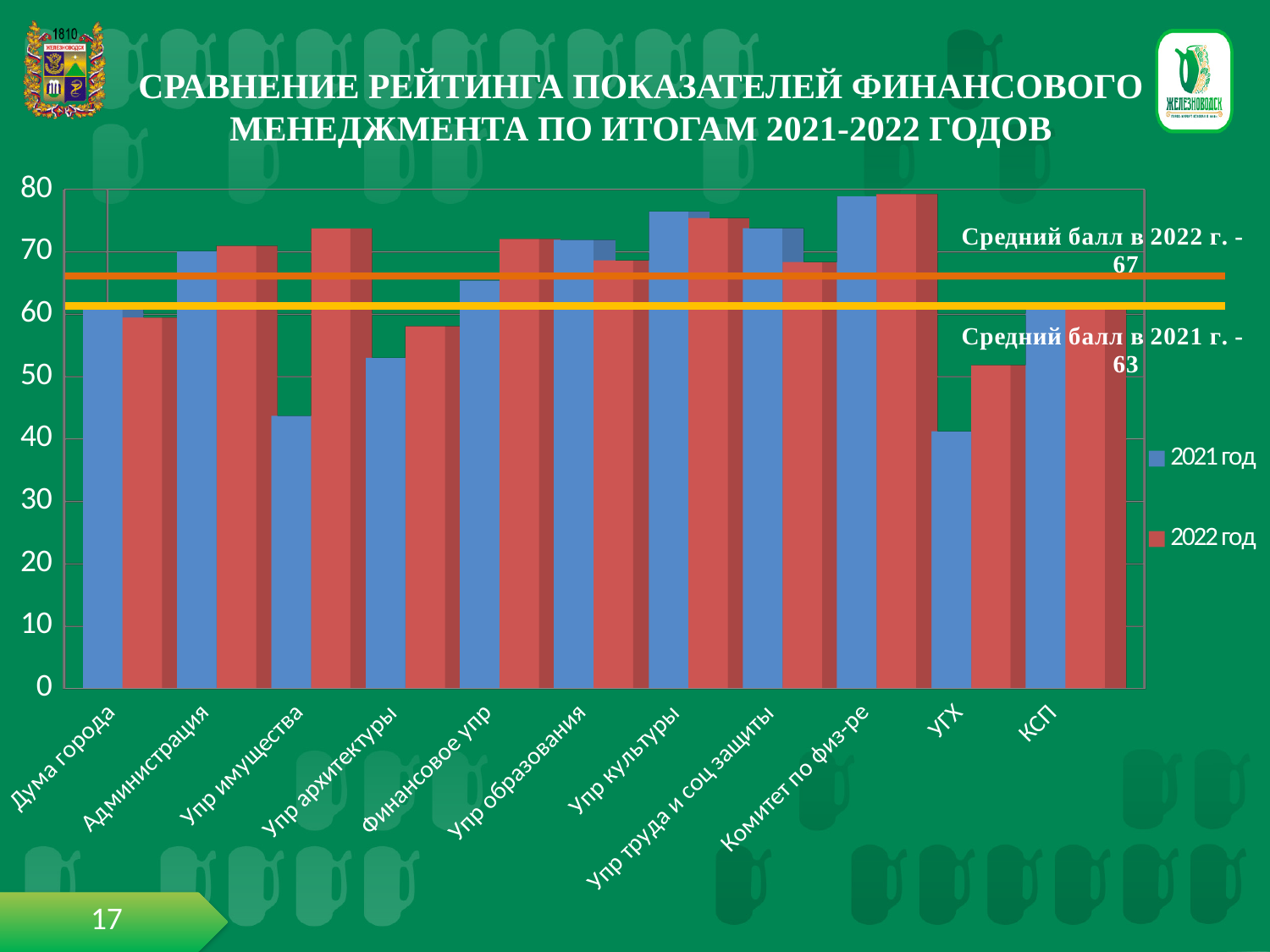
Which category has the lowest 2022 год value? УГХ Is the 2021 год value for Комитет по физ-ре greater or less than 70? greater What kind of chart is shown on the slide? bar chart For Упр имущества, which series has the larger value, 2021 год or 2022 год? 2022 год What colour represents the 2022 год series in the legend? red How many categories are shown along the x axis? 11 By how much does the stated average score for 2022 exceed the stated average score for 2021? 4 What is the average score for 2022 stated on the chart? 67 Is the 2021 год value for УГХ greater or less than 50? less Is the 2022 год value for Упр имущества greater or less than 70? greater What is the average score for 2021 stated on the chart? 63 How many series does the legend list? 2